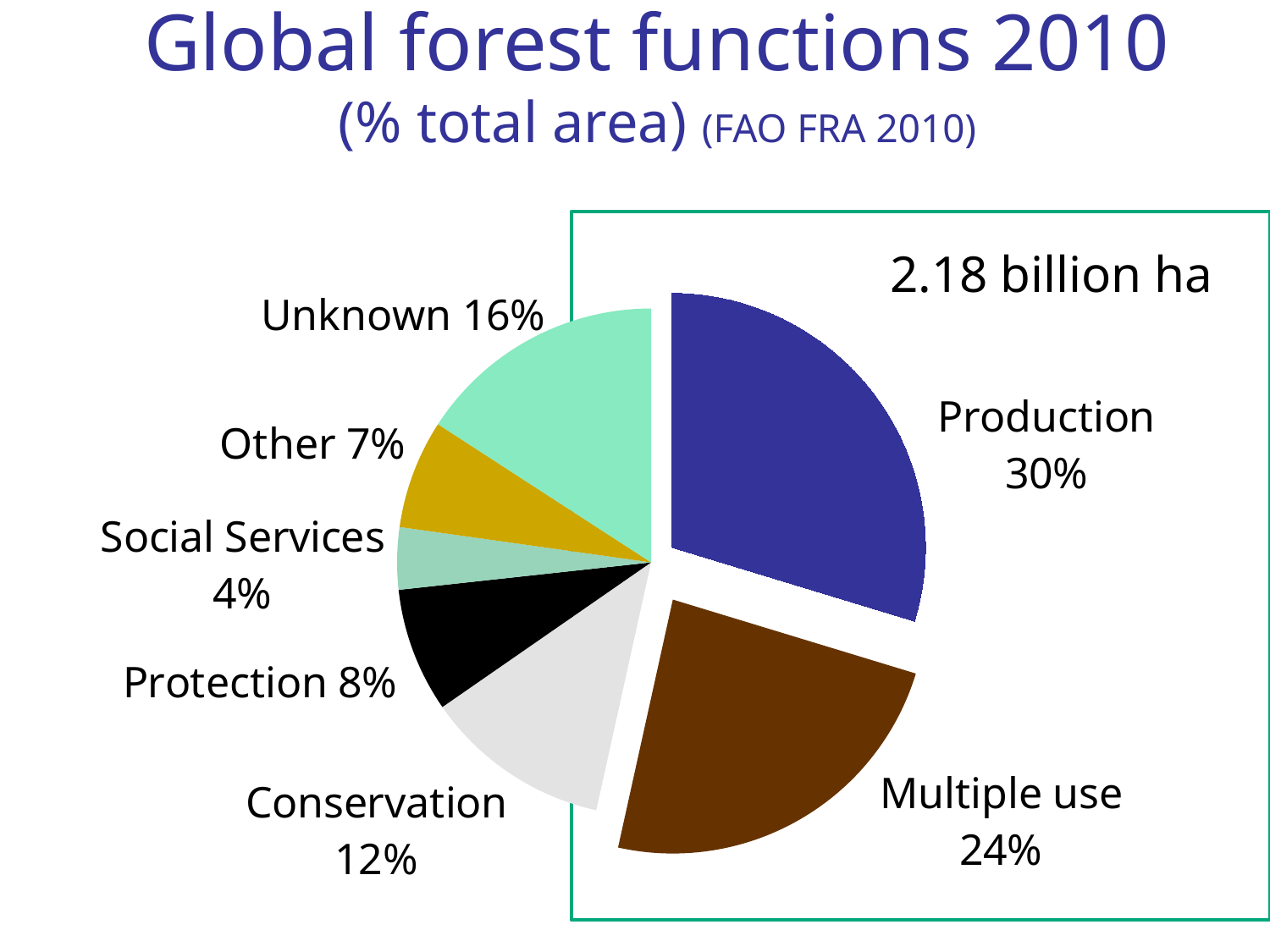
Which forest function has the largest slice of the pie? Production What is the combined percentage of Protection and Other? 15% Which is larger, the Unknown slice or the Conservation slice? Unknown Which forest function has the smallest slice of the pie? Social Services What percentage is shown for Social Services? 4% What kind of chart is shown on the slide? Pie chart What share of total forest area is labelled Production? 30% What total forest area is stated on the slide? 2.18 billion ha What share of total forest area is labelled Multiple use? 24% What is the difference in percentage points between Production and Multiple use? 6 How many slices does the pie chart have? 7 What percentage is shown for Conservation? 12%